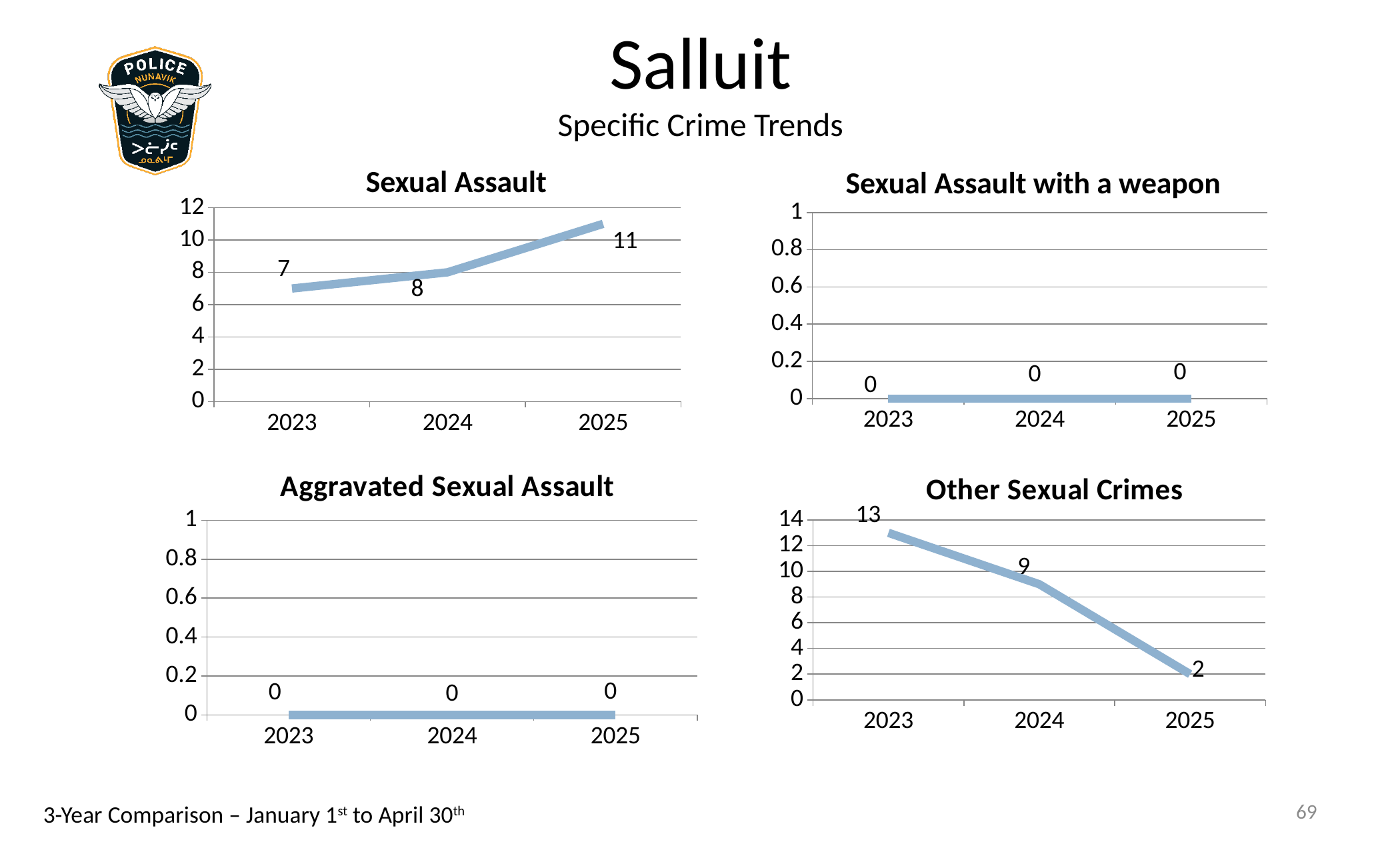
In the Other Sexual Crimes chart, what is the difference between the 2023 and 2025 values? 11 In the Other Sexual Crimes chart, what is the value for 2024? 9 In the Sexual Assault chart, what is the difference between the 2025 and 2023 values? 4 In the Sexual Assault chart, what is the value for 2023? 7 In the Other Sexual Crimes chart, which year has the lowest value? 2025 In the Other Sexual Crimes chart, do the values rise or fall from 2023 to 2025? fall What kind of chart is the Other Sexual Crimes chart? line chart How many years are plotted in the Aggravated Sexual Assault chart? 3 In the Sexual Assault with a weapon chart, what is the value for 2024? 0 In the Sexual Assault chart, what is the value for 2025? 11 In the Sexual Assault chart, which year has the highest value? 2025 In the Sexual Assault chart, do the values rise or fall from 2023 to 2025? rise